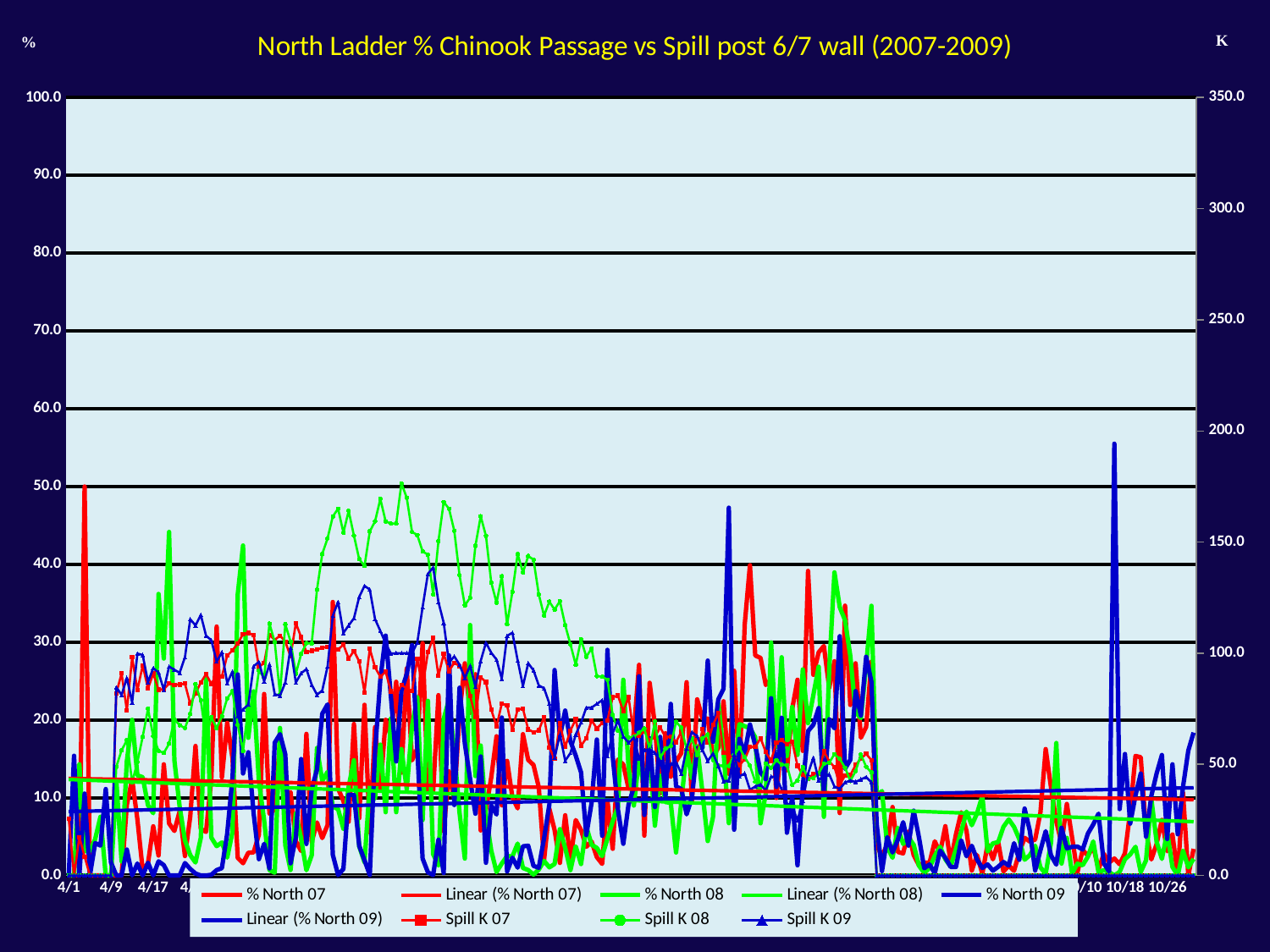
Is the value of the Linear (% North 08) line at the right end of the chart greater or less than 10.0? less Does the Linear (% North 07) trend line rise or fall from left to right? fall Does the Linear (% North 08) trend line rise or fall from left to right? fall What is the title of the chart? North Ladder % Chinook Passage vs Spill post 6/7 wall (2007-2009) Does the Linear (% North 09) trend line rise or fall from left to right? rise Is the value of the Linear (% North 07) line at the left end of the chart greater or less than 10.0? greater What kind of chart is shown on the slide? line chart At the left end of the chart, which is higher: the Linear (% North 07) line or the Linear (% North 09) line? Linear (% North 07) Is the highest peak of the % North 09 line (near 10/10) greater or less than 50.0 on the left axis? greater How many series does the legend list? 9 What is the maximum value shown on the right-hand (K) axis? 350.0